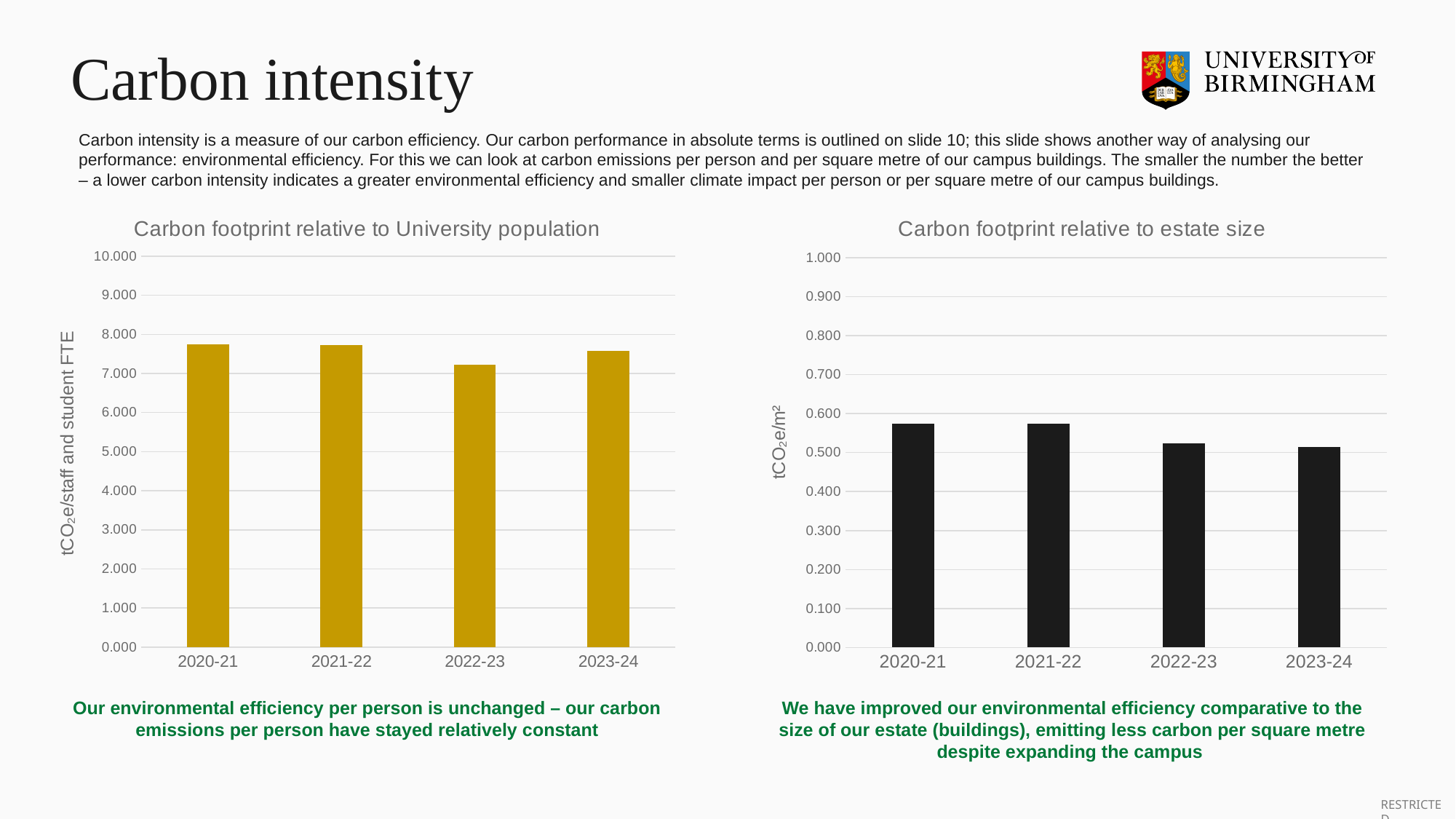
On the 'Carbon footprint relative to estate size' chart, is the value for 2020-21 greater or less than 0.500? greater On the 'Carbon footprint relative to University population' chart, is the value for 2020-21 greater or less than 7.000? greater On the 'Carbon footprint relative to estate size' chart, is the value for 2023-24 greater or less than 0.600? less What is the y-axis label on the 'Carbon footprint relative to estate size' chart? tCO₂e/m² How many years are shown on the 'Carbon footprint relative to estate size' chart? 4 On the 'Carbon footprint relative to University population' chart, which year has the lowest value? 2022-23 On the 'Carbon footprint relative to estate size' chart, which is larger, the value for 2021-22 or the value for 2023-24? 2021-22 What kind of chart is the 'Carbon footprint relative to University population' chart? bar chart What colour are the bars on the 'Carbon footprint relative to University population' chart? gold On the 'Carbon footprint relative to University population' chart, which is larger, the value for 2020-21 or the value for 2022-23? 2020-21 On the 'Carbon footprint relative to estate size' chart, do the values generally rise or fall from 2020-21 to 2023-24? fall